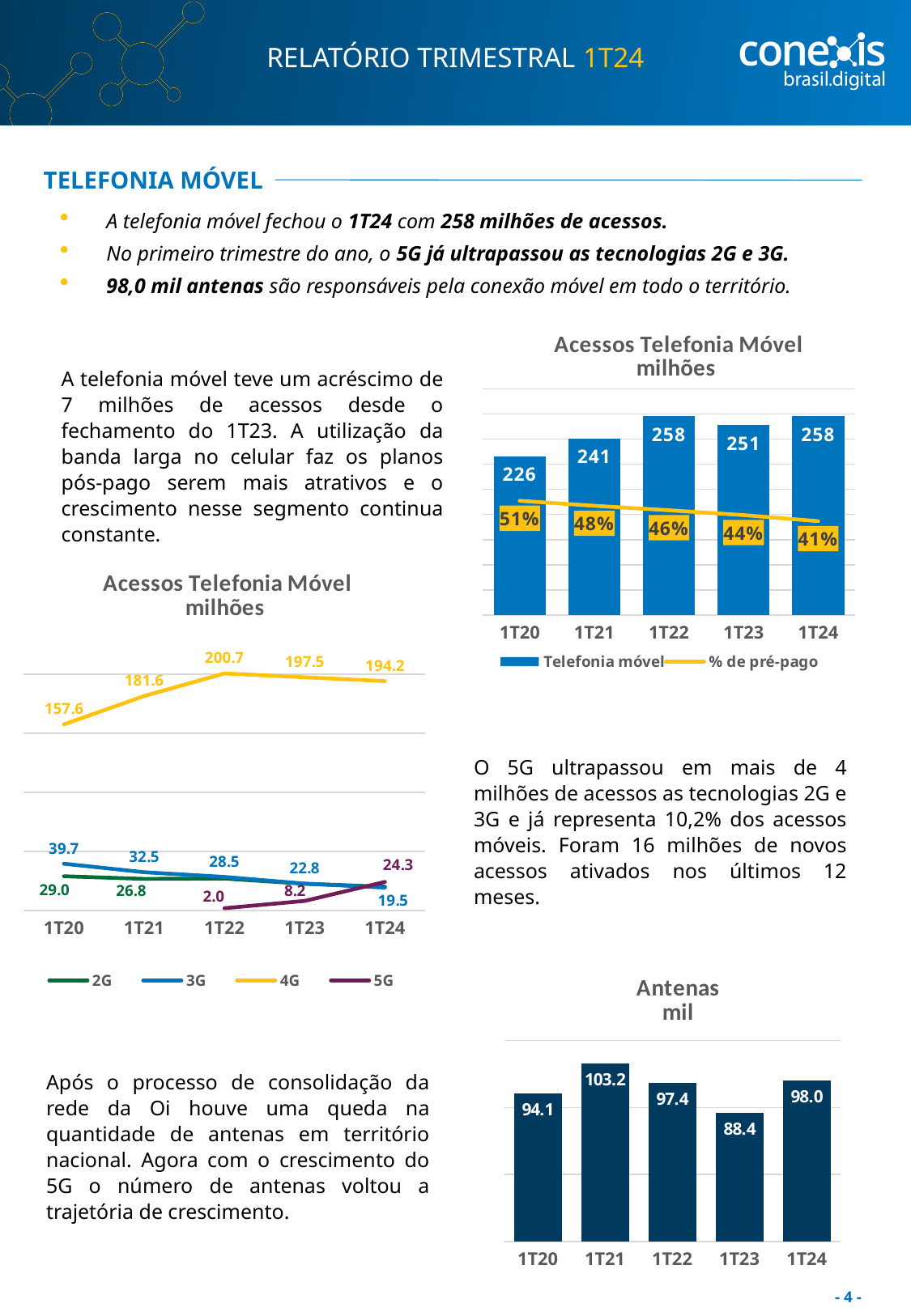
In the left 'Acessos Telefonia Móvel milhões' line chart, what is the 4G value for 1T22? 200.7 What kind of chart is the 'Antenas mil' chart? bar chart In the top-right 'Acessos Telefonia Móvel milhões' bar chart, what is the difference between the 1T24 and 1T20 values for Telefonia móvel? 32 In the top-right 'Acessos Telefonia Móvel milhões' bar chart, does the '% de pré-pago' line rise or fall from 1T20 to 1T24? fall In the left 'Acessos Telefonia Móvel milhões' line chart, how many series does the legend list? 4 In the left 'Acessos Telefonia Móvel milhões' line chart, what is the 5G value for 1T24? 24.3 In the top-right 'Acessos Telefonia Móvel milhões' bar chart, what is the value for 1T21? 241 In the top-right 'Acessos Telefonia Móvel milhões' bar chart, how many series does the legend list? 2 In the 'Antenas mil' chart, which quarter has the lowest value? 1T23 In the top-right 'Acessos Telefonia Móvel milhões' bar chart, what is the '% de pré-pago' value for 1T24? 41% In the left 'Acessos Telefonia Móvel milhões' line chart, which series has the highest value in 1T24? 4G In the 'Antenas mil' chart, what is the difference between the 1T21 and 1T23 values? 14.8